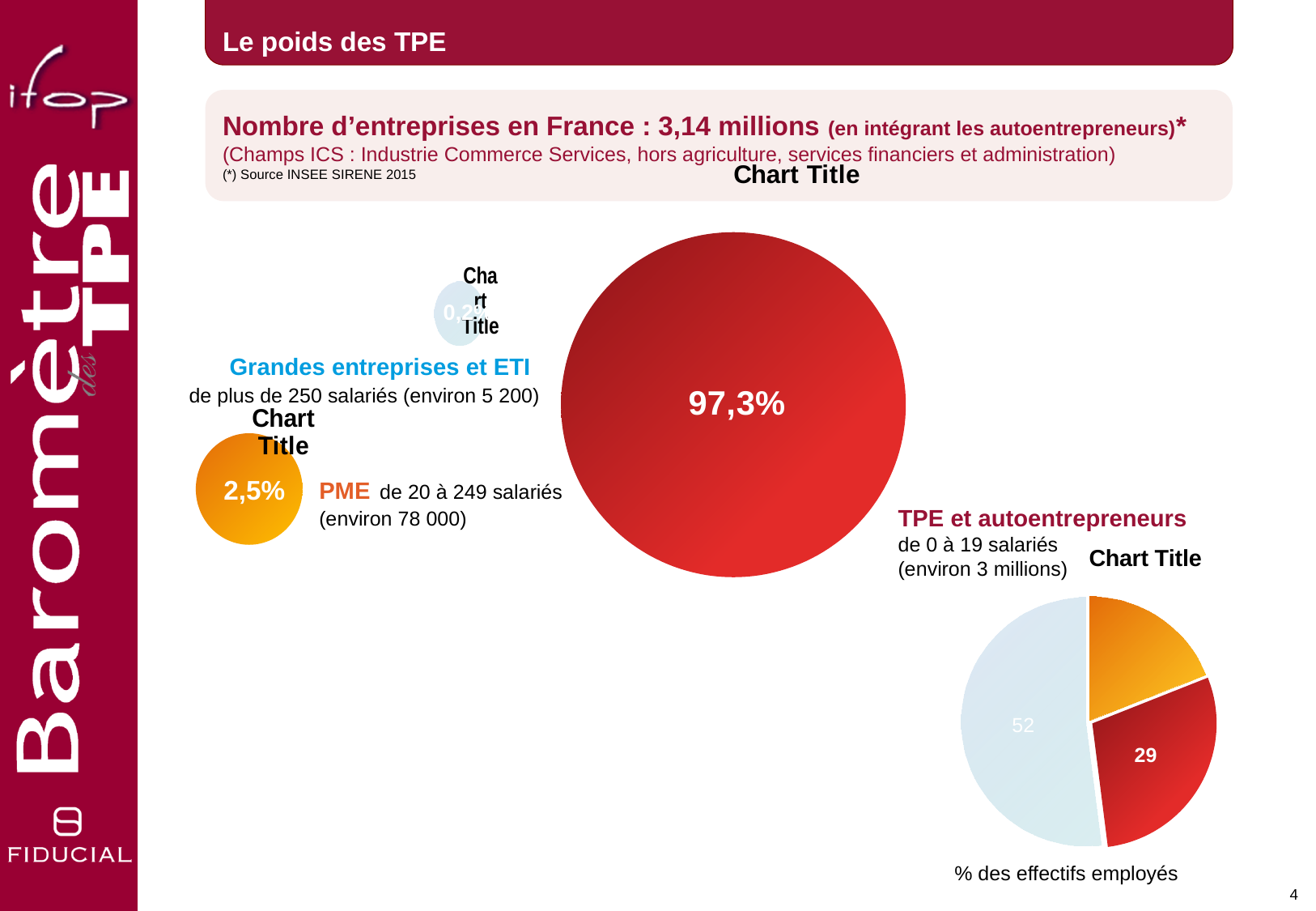
What is the difference between the percentage for TPE et autoentrepreneurs (97,3%) and the percentage for PME (2,5%) in the circle charts? 94,8% Among the three circle charts (TPE et autoentrepreneurs, PME, Grandes entreprises et ETI), which category has the lowest percentage? Grandes entreprises et ETI Comparing the circle charts, which is larger: the percentage for PME or the percentage for Grandes entreprises et ETI? PME Among the three circle charts (TPE et autoentrepreneurs, PME, Grandes entreprises et ETI), which category has the highest percentage? TPE et autoentrepreneurs How many slices does the pie chart at the bottom right of the slide have? 3 In the pie chart at the bottom right of the slide, what is the difference between the light-blue slice (52) and the red slice (29)? 23 In the large red circle chart in the centre of the slide, what percentage is shown for TPE et autoentrepreneurs? 97,3% In the pie chart at the bottom right of the slide, what is the value of the largest slice? 52 In the small light-blue circle chart near the top left, what percentage is shown for Grandes entreprises et ETI? 0,2% In the pie chart at the bottom right of the slide, what value is shown on the red slice? 29 What kind of chart is the chart at the bottom right of the slide, captioned '% des effectifs employés'? Pie chart In the orange circle chart on the left of the slide, what percentage is shown for PME? 2,5%